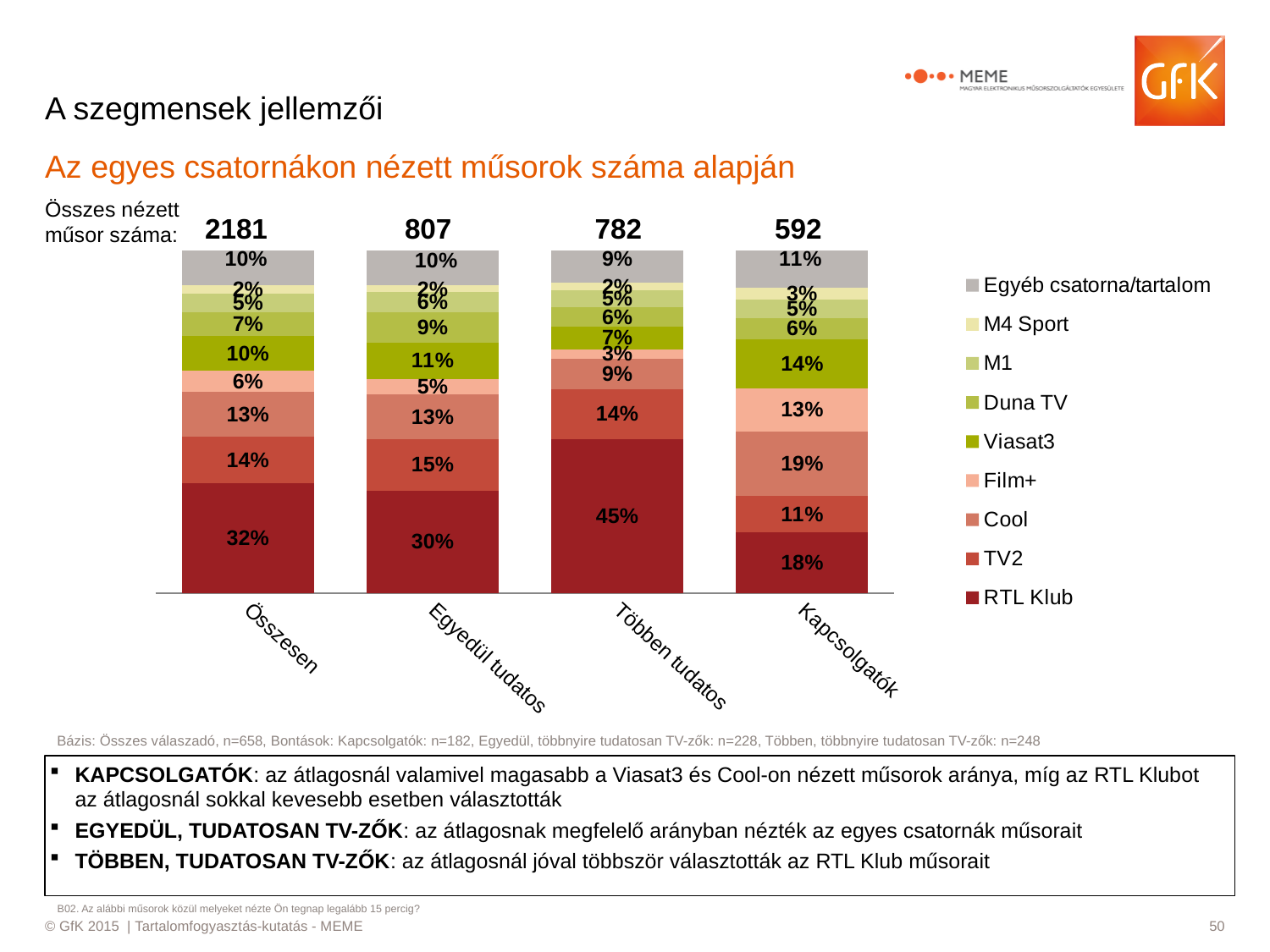
Which series is listed at the bottom of the legend? RTL Klub What is the total number of watched programmes (Összes nézett műsor száma) shown above the Egyedül tudatos bar? 807 How many series does the legend list? 9 Is the Film+ share larger for Kapcsolgatók or for Összesen? Kapcsolgatók Which segment has the lowest RTL Klub share? Kapcsolgatók What is the Viasat3 share for the Egyedül tudatos segment? 11% What is the RTL Klub share for the Többen tudatos segment? 45% How many categories are shown along the x axis? 4 What kind of chart is shown on the slide? stacked bar chart Which segment has the highest RTL Klub share? Többen tudatos What is the Cool share for the Kapcsolgatók segment? 19% What is the difference between the RTL Klub share for Összesen and for Kapcsolgatók? 14%